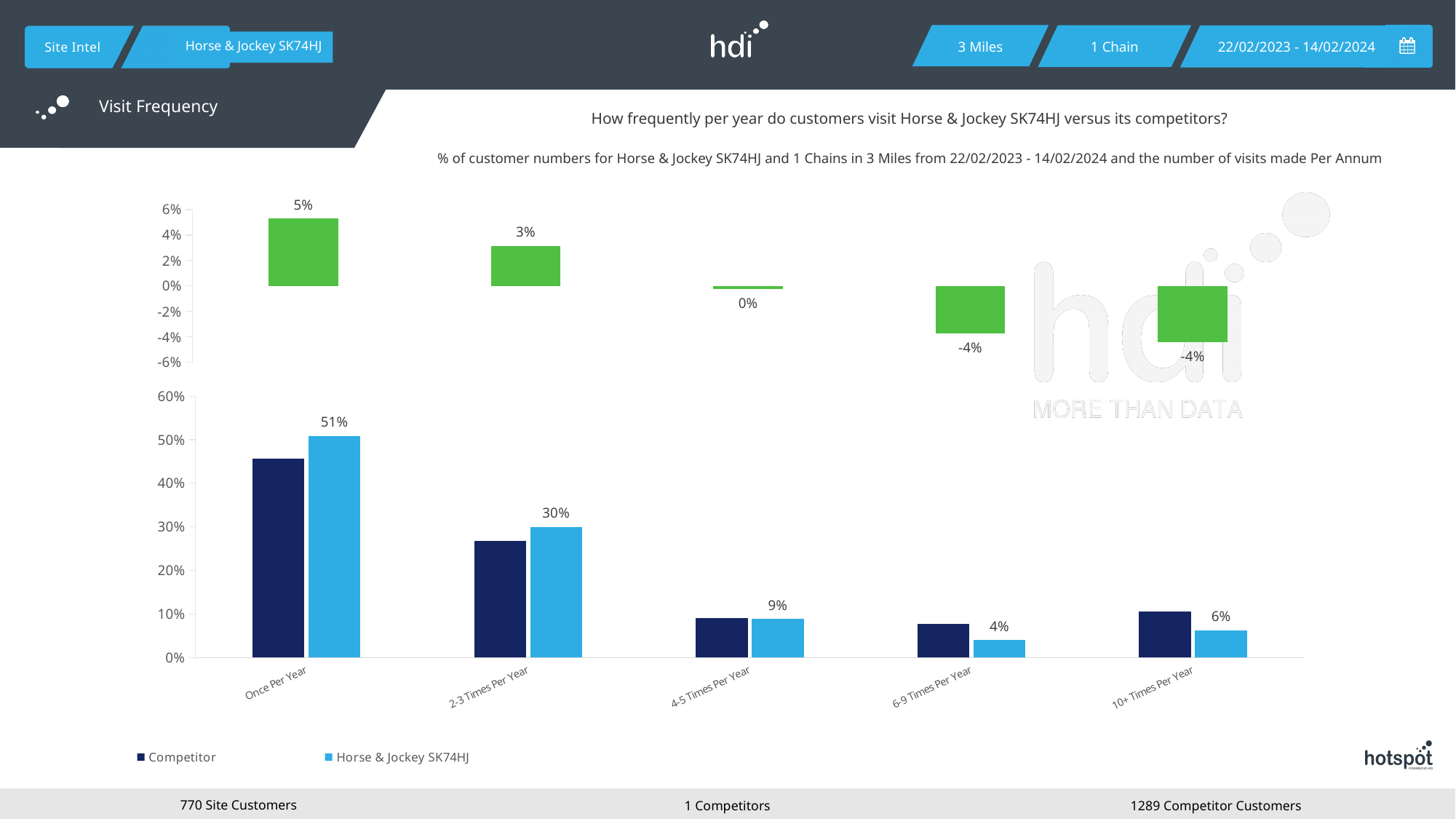
In the bottom chart, what is the Horse & Jockey SK74HJ value for 2-3 Times Per Year? 30% How many series does the legend of the bottom chart list? 2 In the top chart, what is the value shown for the first (Once Per Year) green bar? 5% In the bottom chart, what is the Horse & Jockey SK74HJ value for 6-9 Times Per Year? 4% How many visit frequency categories are shown on the x axis of the bottom chart? 5 In the bottom chart, which visit frequency category has the highest Horse & Jockey SK74HJ value? Once Per Year In the top chart, what is the value shown for the third (4-5 Times Per Year) green bar? 0% In the bottom chart, is the Competitor value for Once Per Year greater or less than 40%? greater In the bottom chart, which visit frequency category has the lowest Horse & Jockey SK74HJ value? 6-9 Times Per Year In the bottom chart, what percentage of Horse & Jockey SK74HJ customers visit Once Per Year? 51% In the bottom chart, what is the difference between the Horse & Jockey SK74HJ values for Once Per Year and 2-3 Times Per Year? 21% In the bottom chart, for Once Per Year, which is larger: the Competitor bar or the Horse & Jockey SK74HJ bar? Horse & Jockey SK74HJ